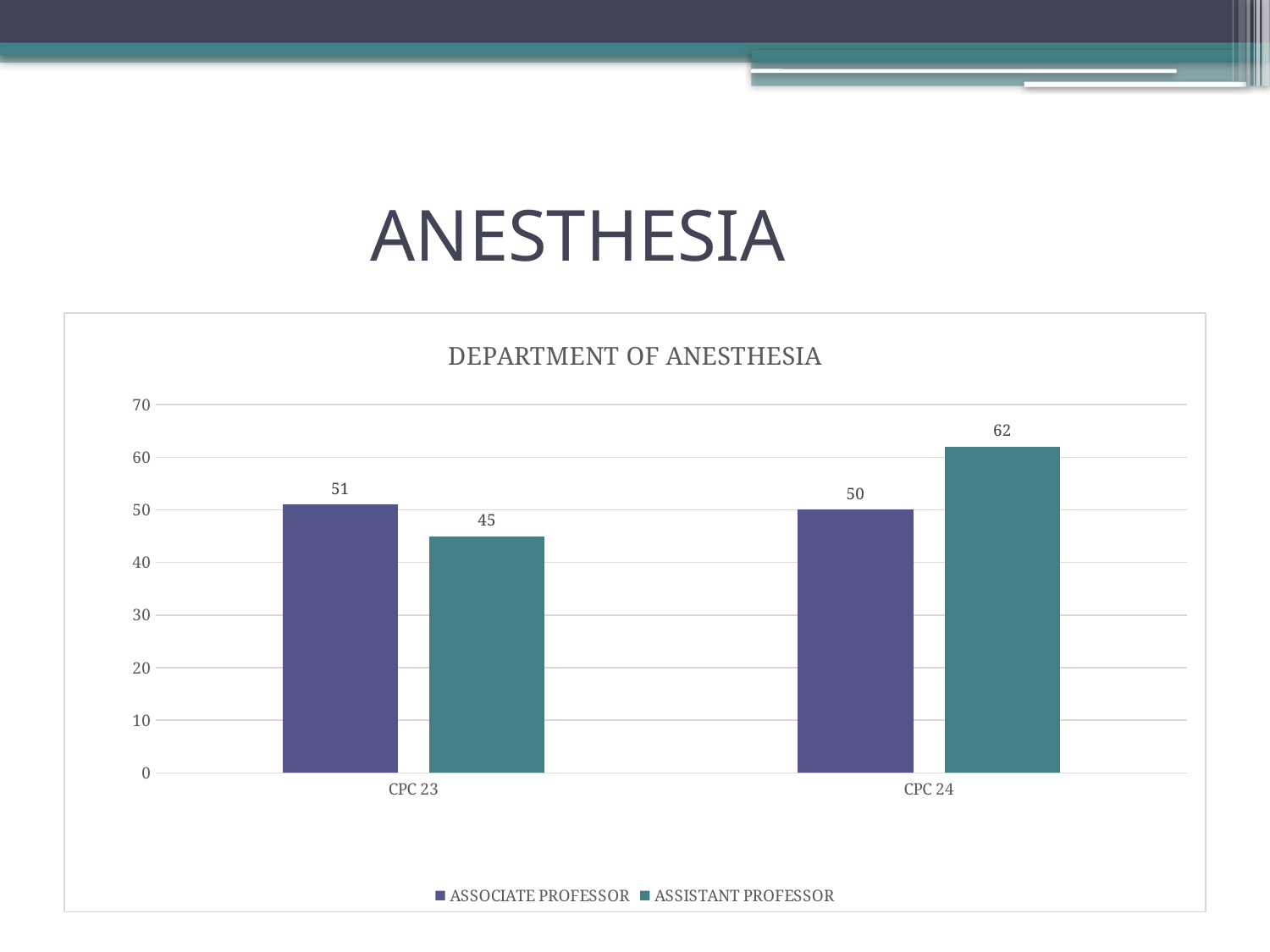
How many categories are shown on the x axis? 2 What is the value for ASSOCIATE PROFESSOR at CPC 23? 51 What is the difference between the ASSISTANT PROFESSOR values at CPC 24 and CPC 23? 17 What is the value for ASSOCIATE PROFESSOR at CPC 24? 50 What is the value for ASSISTANT PROFESSOR at CPC 24? 62 What is the title of the chart? DEPARTMENT OF ANESTHESIA How many series does the legend list? 2 At CPC 24, which series has the larger value, ASSOCIATE PROFESSOR or ASSISTANT PROFESSOR? ASSISTANT PROFESSOR Which bar has the highest value in the chart? ASSISTANT PROFESSOR at CPC 24 Which bar has the lowest value in the chart? ASSISTANT PROFESSOR at CPC 23 What is the value for ASSISTANT PROFESSOR at CPC 23? 45 What kind of chart is shown on the slide? Bar chart